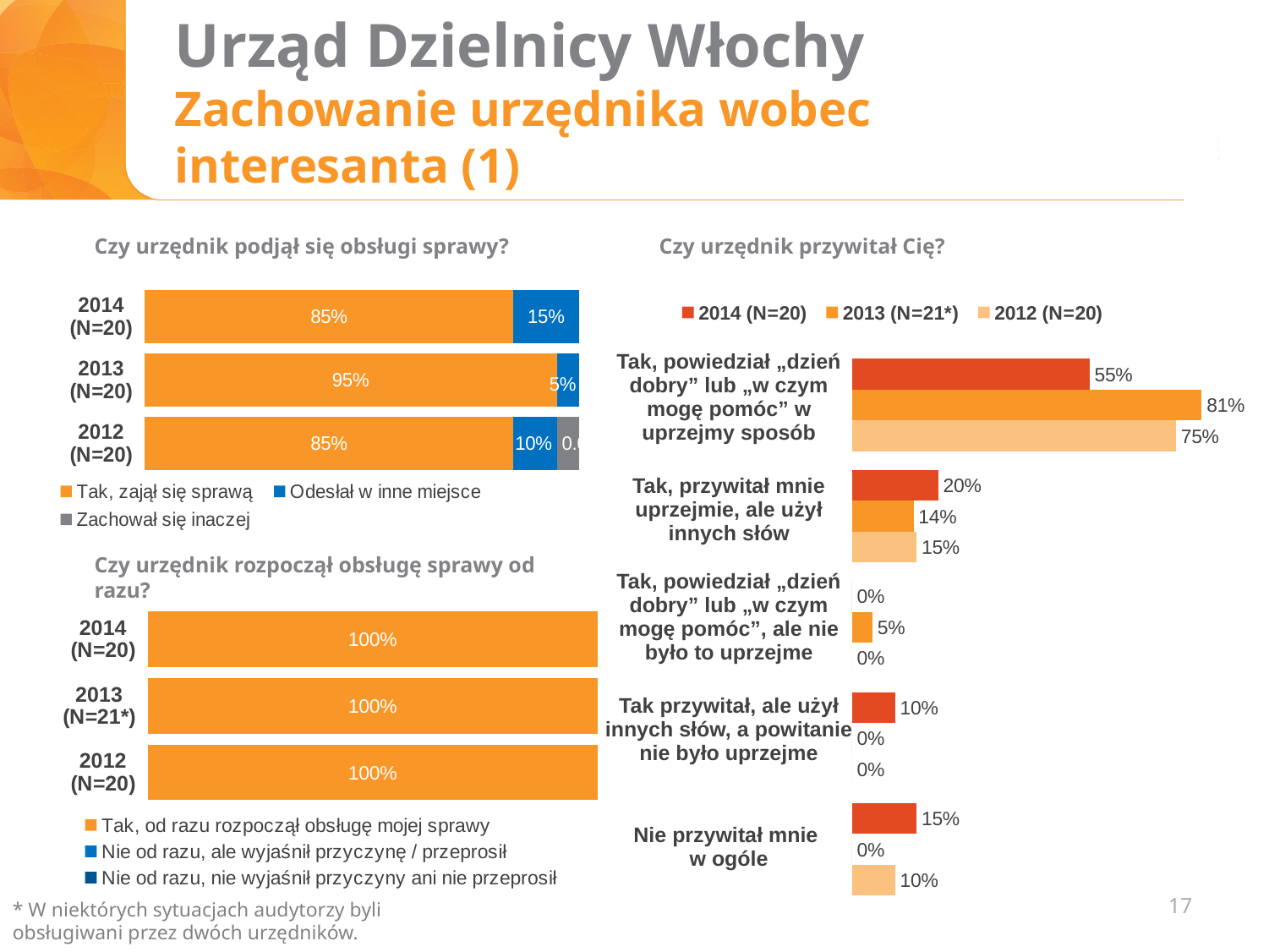
In the chart "Czy urzędnik podjął się obsługi sprawy?", what percentage for 2013 (N=20) is "Odesłał w inne miejsce"? 5% In the chart "Czy urzędnik przywitał Cię?", what is the difference between the 2013 (N=21*) and 2014 (N=20) values for "Tak, powiedział „dzień dobry” lub „w czym mogę pomóc” w uprzejmy sposób"? 26% In the chart "Czy urzędnik podjął się obsługi sprawy?", how many series does the legend list? 3 In the chart "Czy urzędnik rozpoczął obsługę sprawy od razu?", how many years are shown? 3 In the chart "Czy urzędnik przywitał Cię?", which is larger for "Tak, przywitał mnie uprzejmie, ale użył innych słów": 2014 (N=20) or 2012 (N=20)? 2014 (N=20) What type of chart is "Czy urzędnik przywitał Cię?"? Bar chart In the chart "Czy urzędnik przywitał Cię?", what is the 2013 (N=21*) value for "Tak, powiedział „dzień dobry” lub „w czym mogę pomóc” w uprzejmy sposób"? 81% In the chart "Czy urzędnik przywitał Cię?", what is the 2014 (N=20) value for "Nie przywitał mnie w ogóle"? 15% In the chart "Czy urzędnik rozpoczął obsługę sprawy od razu?", what is the value for 2013 (N=21*) for "Tak, od razu rozpoczął obsługę mojej sprawy"? 100% In the chart "Czy urzędnik przywitał Cię?", how many series does the legend list? 3 In the chart "Czy urzędnik podjął się obsługi sprawy?", which year has the highest share of "Tak, zajął się sprawą"? 2013 (N=20) In the chart "Czy urzędnik podjął się obsługi sprawy?", what percentage for 2014 (N=20) is "Tak, zajął się sprawą"? 85%